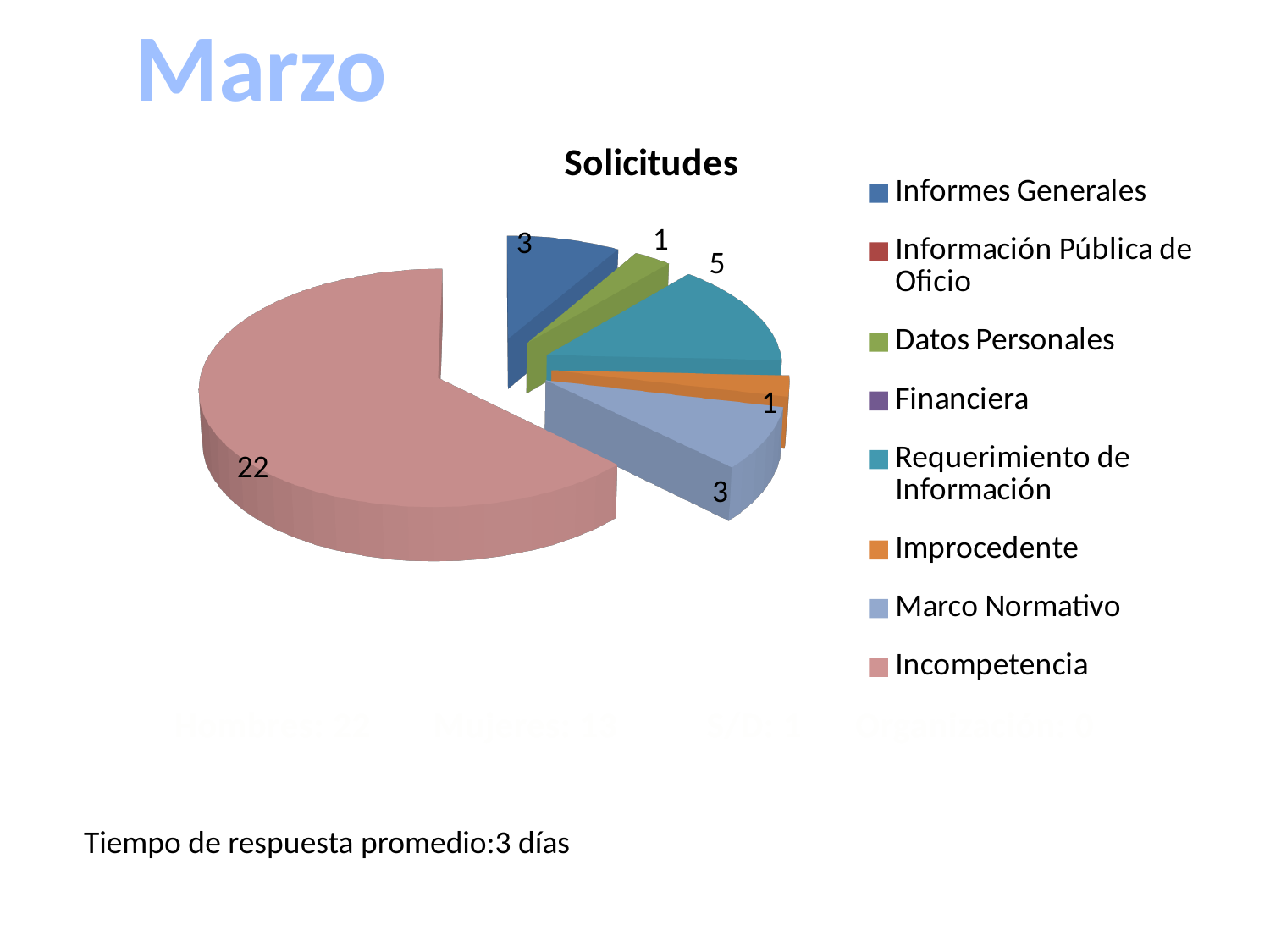
How many entries does the legend list? 8 Which category has the largest slice of the pie? Incompetencia What is the value for Incompetencia? 22 What is the value for Datos Personales? 1 Which is larger, the value for Requerimiento de Información or the value for Informes Generales? Requerimiento de Información What kind of chart is shown on the slide? pie chart What is the value for Informes Generales? 3 What is the value for Improcedente? 1 What is the value for Requerimiento de Información? 5 What is the value for Marco Normativo? 3 What is the title of the chart? Solicitudes What is the difference between the values for Incompetencia and Requerimiento de Información? 17